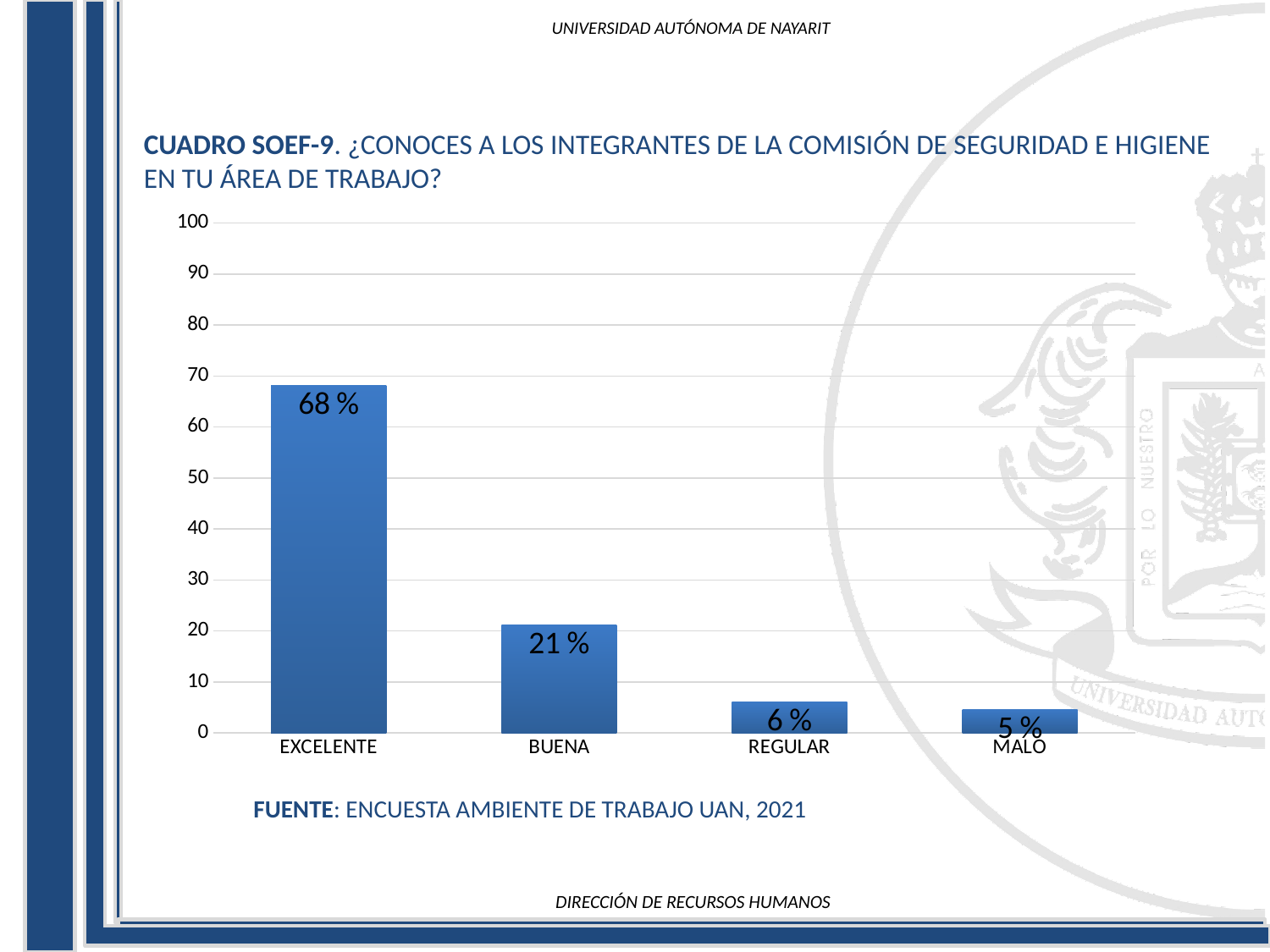
What is the value for EXCELENTE? 68 % What is the value for MALO? 5 % What kind of chart is shown on the slide? bar chart How many categories are shown on the x axis? 4 Which is larger, the value for BUENA or the value for REGULAR? BUENA What is the value for REGULAR? 6 % What source is cited below the chart? ENCUESTA AMBIENTE DE TRABAJO UAN, 2021 What is the value for BUENA? 21 % Which category has the lowest value? MALO What is the difference between the values for EXCELENTE and BUENA? 47 % Which category has the highest value? EXCELENTE Is the value for EXCELENTE greater or less than 60? greater